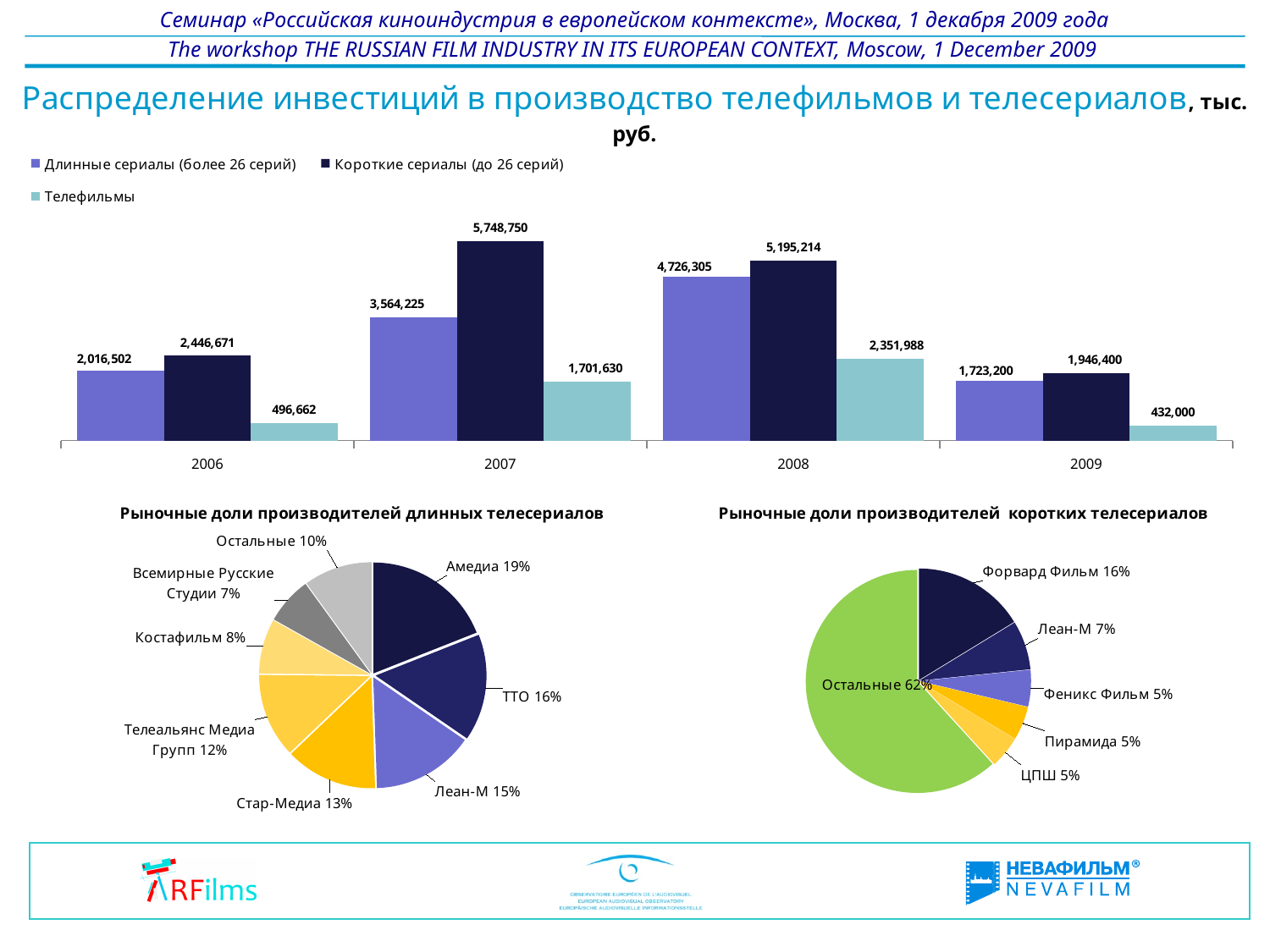
In the pie chart 'Рыночные доли производителей коротких телесериалов', which slice is the largest? Остальные In the top bar chart, what is the value for Телефильмы in 2009? 432,000 How many series does the legend of the top bar chart list? 3 What kind of chart is the top chart on the slide? Bar chart How many years are shown on the x axis of the top bar chart? 4 In the top bar chart, what is the difference between Короткие сериалы and Длинные сериалы in 2006? 430,169 In the top bar chart, which year has the lowest value for Телефильмы? 2009 In the pie chart 'Рыночные доли производителей длинных телесериалов', what share does Амедиа have? 19% In the top bar chart, which year has the highest value for Длинные сериалы (более 26 серий)? 2008 In the top bar chart, what is the value for Короткие сериалы (до 26 серий) in 2007? 5,748,750 In the top bar chart, which is larger in 2008: Длинные сериалы or Короткие сериалы? Короткие сериалы In the pie chart 'Рыночные доли производителей коротких телесериалов', what share does Форвард Фильм have? 16%